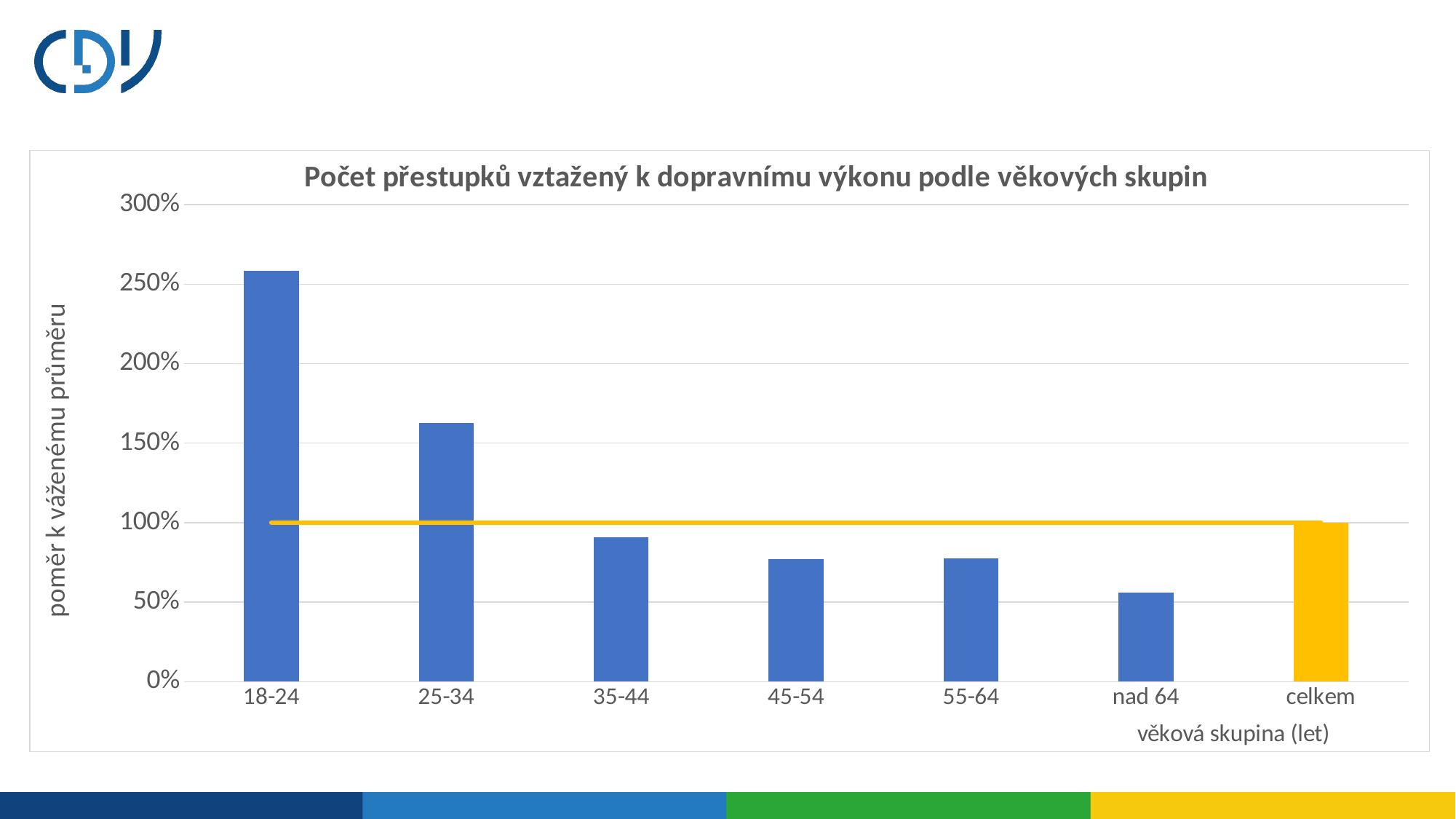
How many categories are shown on the x axis of the chart? 7 Is the value for 35-44 greater or less than 100%? less Is the value for nad 64 greater or less than 50%? greater Which age group has the lowest value in the chart? nad 64 Is the value for 25-34 greater or less than 150%? greater Which age group has the highest value in the chart? 18-24 Do the values generally rise or fall from the 18-24 group to the nad 64 group? fall What type of chart is shown on the slide? combination bar and line chart What is the value for celkem? 100% Which is larger, the value for 18-24 or the value for 25-34? 18-24 What is the title of the chart? Počet přestupků vztažený k dopravnímu výkonu podle věkových skupin